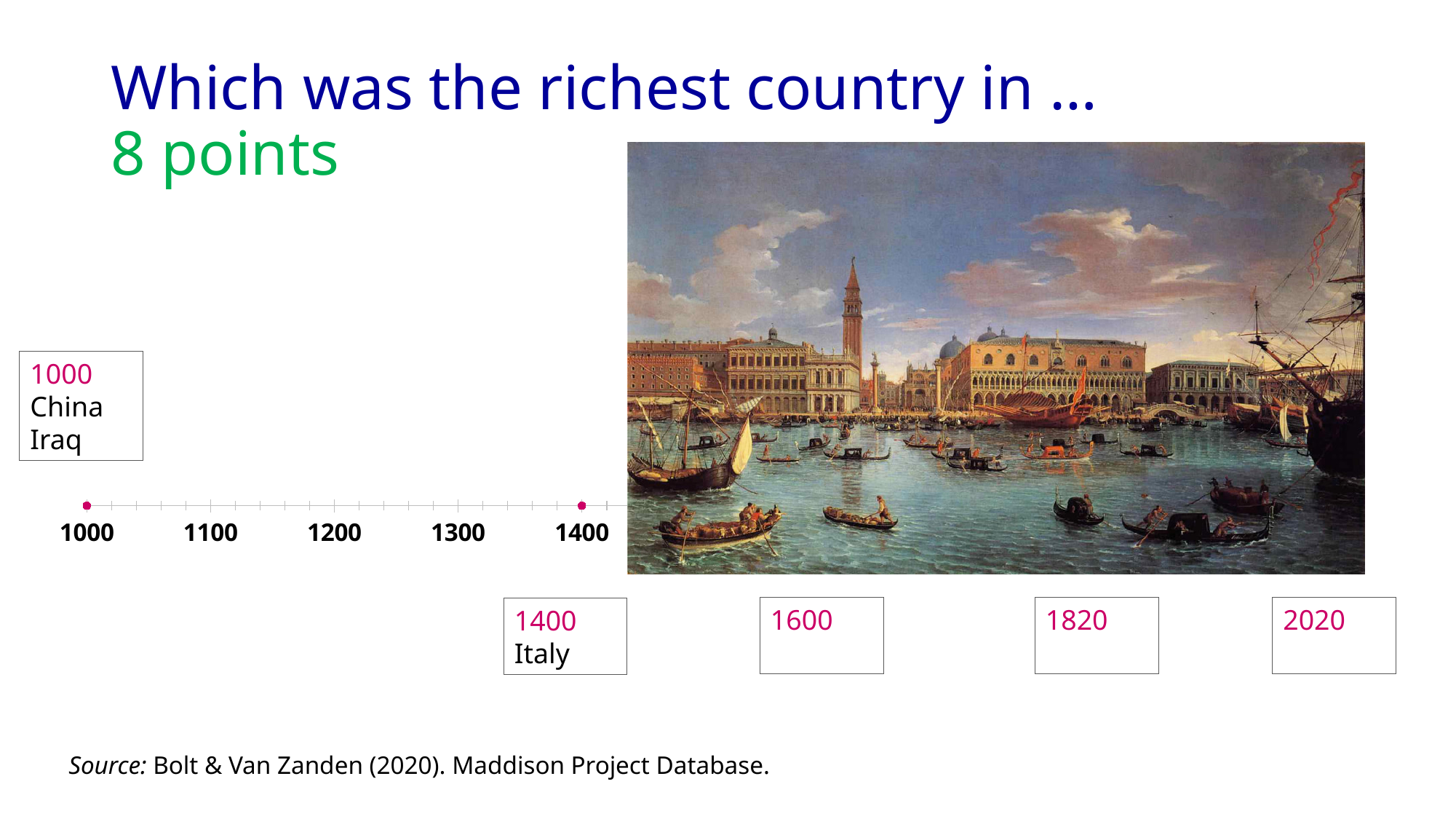
How many year boxes below the timeline have no country filled in? 3 Which country is labelled as the richest in 1400? Italy Which of the two marked points on the timeline is further to the right, 1000 or 1400? 1400 What is the leftmost year label on the timeline axis? 1000 What is the spacing between consecutive year labels on the timeline axis? 100 What source is cited for the timeline data? Bolt & Van Zanden (2020). Maddison Project Database. How many years apart are the two marked points on the timeline? 400 What is the rightmost visible year label on the timeline axis? 1400 How many marked points are visible on the timeline axis? 2 Which years appear in the boxes below the timeline? 1400, 1600, 1820, 2020 Which countries are labelled for the year 1000? China, Iraq